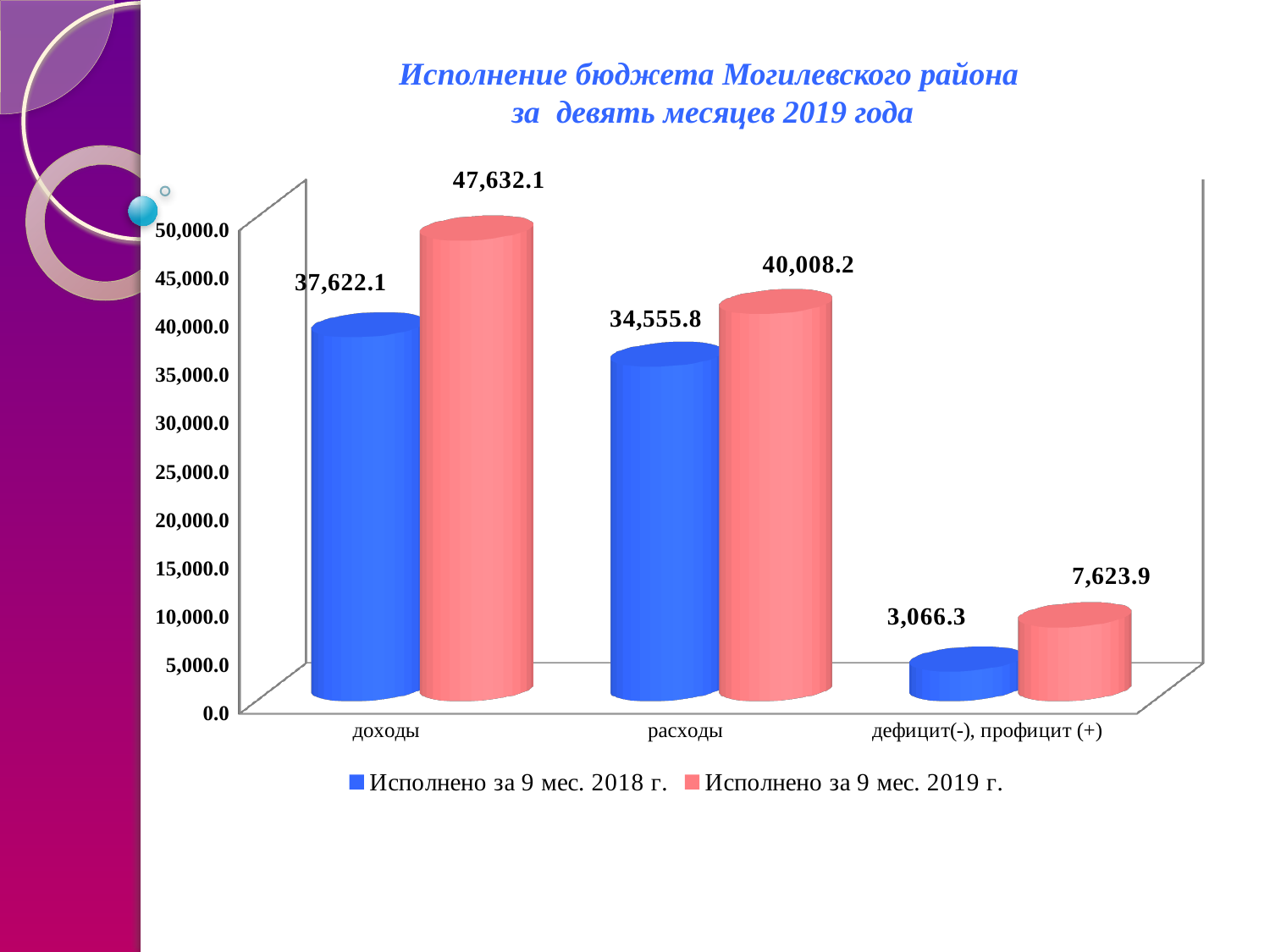
What is the value for доходы in the series Исполнено за 9 мес. 2018 г.? 37,622.1 What is the value for расходы in the series Исполнено за 9 мес. 2018 г.? 34,555.8 What is the difference between the 2019 and 2018 values for доходы? 10,010.0 Which category has the highest value in the series Исполнено за 9 мес. 2019 г.? доходы What is the value for дефицит(-), профицит (+) in the series Исполнено за 9 мес. 2019 г.? 7,623.9 How many categories are shown on the x axis? 3 How many series does the legend list? 2 What kind of chart is shown on the slide? bar chart Which category has the lowest value in the series Исполнено за 9 мес. 2018 г.? дефицит(-), профицит (+) What is the value for доходы in the series Исполнено за 9 мес. 2019 г.? 47,632.1 What is the difference between the 2019 and 2018 values for расходы? 5,452.4 Which is larger: расходы for Исполнено за 9 мес. 2019 г. or доходы for Исполнено за 9 мес. 2018 г.? расходы for Исполнено за 9 мес. 2019 г.